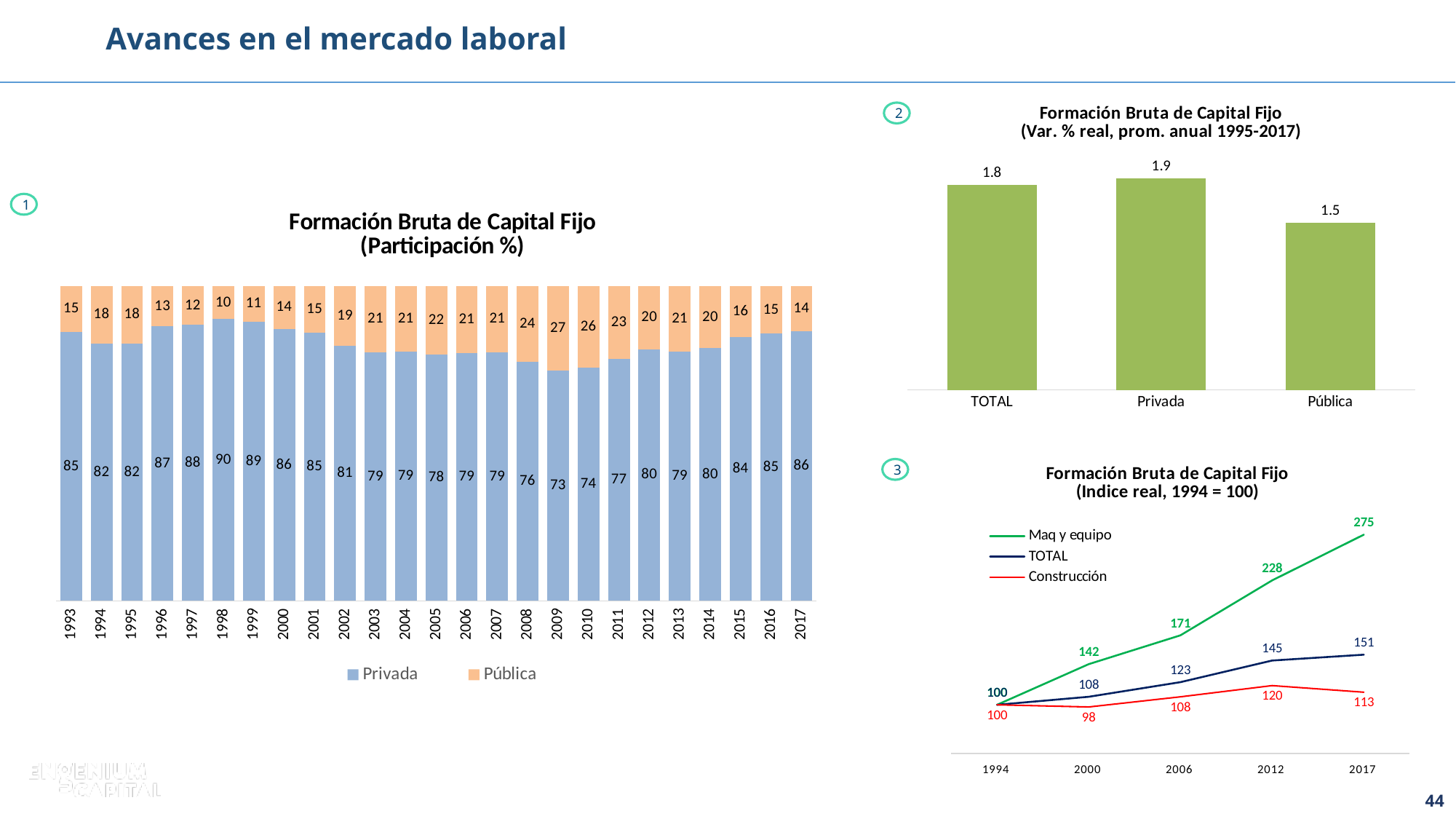
In the chart titled 'Formación Bruta de Capital Fijo (Participación %)', how many series does the legend list? 2 In the chart titled 'Formación Bruta de Capital Fijo (Var. % real, prom. anual 1995-2017)', which category has the highest value? Privada In the chart titled 'Formación Bruta de Capital Fijo (Indice real, 1994 = 100)', does the Maq y equipo series rise or fall from 1994 to 2017? Rise In the chart titled 'Formación Bruta de Capital Fijo (Participación %)', what is the value for Pública in 2009? 27 In the chart titled 'Formación Bruta de Capital Fijo (Indice real, 1994 = 100)', which is larger in 2017: TOTAL or Construcción? TOTAL In the chart titled 'Formación Bruta de Capital Fijo (Participación %)', what is the value for Privada in 1998? 90 In the chart titled 'Formación Bruta de Capital Fijo (Participación %)', which year has the highest Pública value? 2009 In the chart titled 'Formación Bruta de Capital Fijo (Indice real, 1994 = 100)', what is the value for Maq y equipo in 2012? 228 In the chart titled 'Formación Bruta de Capital Fijo (Var. % real, prom. anual 1995-2017)', what is the difference between the Privada and Pública values? 0.4 In the chart titled 'Formación Bruta de Capital Fijo (Var. % real, prom. anual 1995-2017)', what is the value for Pública? 1.5 In the chart titled 'Formación Bruta de Capital Fijo (Participación %)', how many years are shown on the x axis? 25 What kind of chart is the one titled 'Formación Bruta de Capital Fijo (Var. % real, prom. anual 1995-2017)'? Bar chart